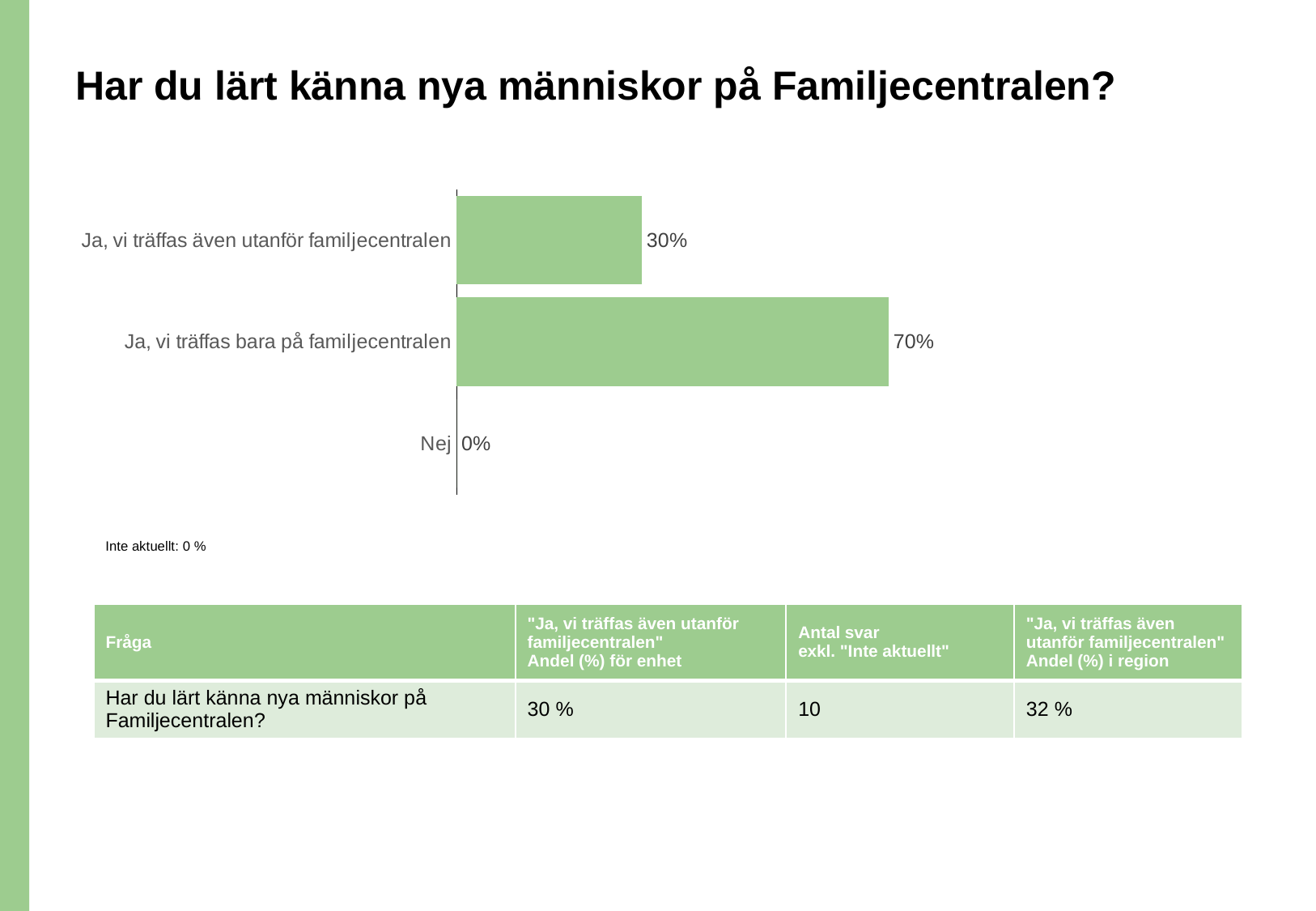
Which is larger: the value for "Ja, vi träffas även utanför familjecentralen" or the value for "Ja, vi träffas bara på familjecentralen"? Ja, vi träffas bara på familjecentralen What is the value for "Ja, vi träffas bara på familjecentralen"? 70% What is the value for "Nej"? 0% Which category has the lowest value? Nej What kind of chart is shown on the slide? Bar chart How many categories does the chart show? 3 Which category has the highest value? Ja, vi träffas bara på familjecentralen What colour are the bars in the chart? Green What is the title of the slide? Har du lärt känna nya människor på Familjecentralen? What is the value for "Ja, vi träffas även utanför familjecentralen"? 30% What is the difference between the values for "Ja, vi träffas bara på familjecentralen" and "Ja, vi träffas även utanför familjecentralen"? 40%